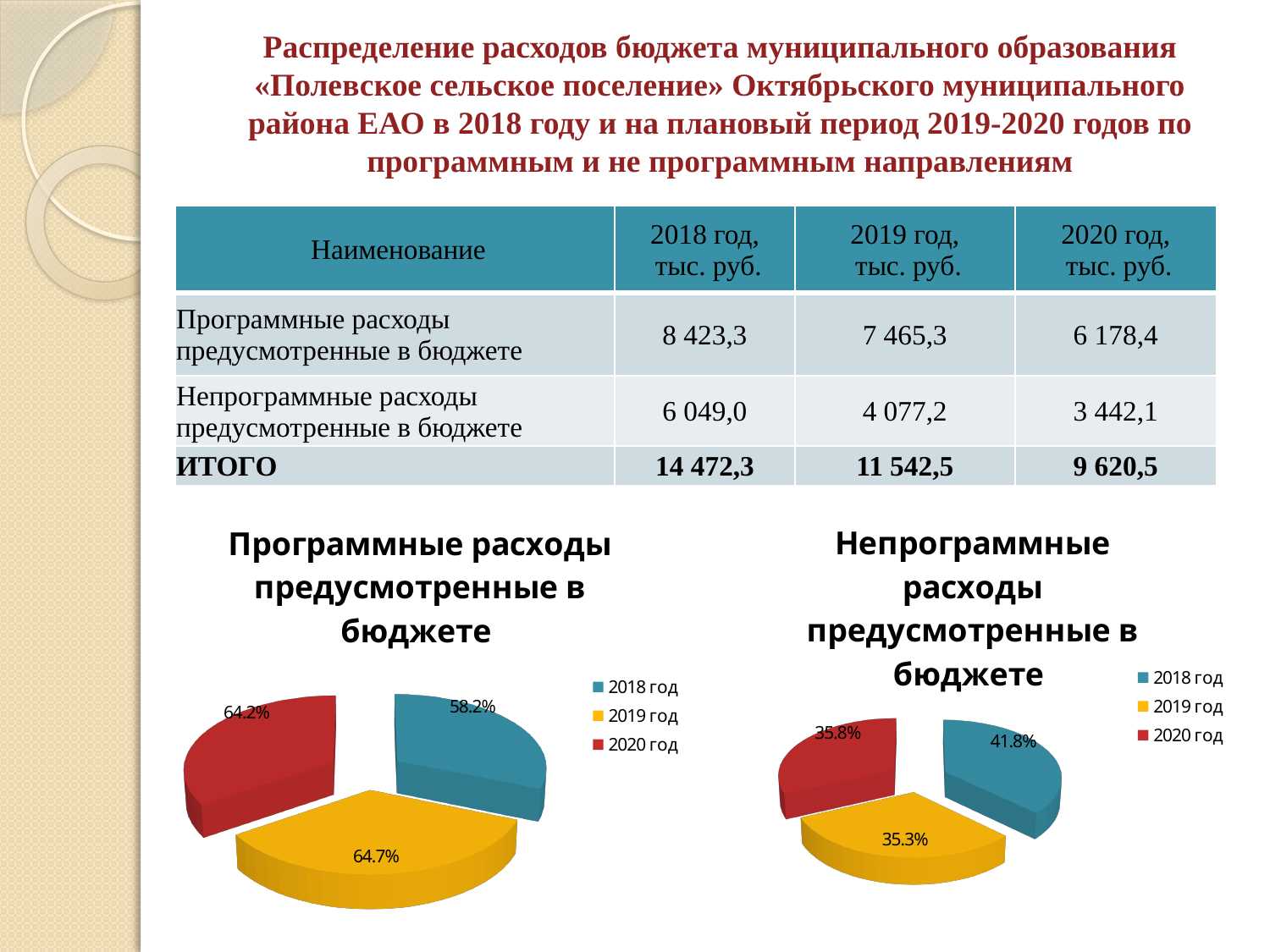
In the left pie chart (Программные расходы предусмотренные в бюджете), what is the value labelled for 2018 год? 58.2% In the left pie chart (Программные расходы предусмотренные в бюджете), what is the value labelled for 2019 год? 64.7% In the left pie chart (Программные расходы предусмотренные в бюджете), what is the value labelled for 2020 год? 64.2% In the right pie chart (Непрограммные расходы предусмотренные в бюджете), what is the value labelled for 2018 год? 41.8% In the right pie chart (Непрограммные расходы предусмотренные в бюджете), which year has the highest labelled value? 2018 год In the right pie chart (Непрограммные расходы предусмотренные в бюджете), what is the value labelled for 2020 год? 35.8% In the left pie chart (Программные расходы предусмотренные в бюджете), which is larger, the value for 2018 год or for 2019 год? 2019 год In the right pie chart (Непрограммные расходы предусмотренные в бюджете), what is the difference between the labelled values for 2018 год and 2019 год? 6.5% In the right pie chart (Непрограммные расходы предусмотренные в бюджете), what is the value labelled for 2019 год? 35.3% What type of chart is used for "Программные расходы предусмотренные в бюджете"? Pie chart In the left pie chart (Программные расходы предусмотренные в бюджете), which year has the lowest labelled value? 2018 год How many entries does the legend of the left pie chart (Программные расходы предусмотренные в бюджете) list? 3